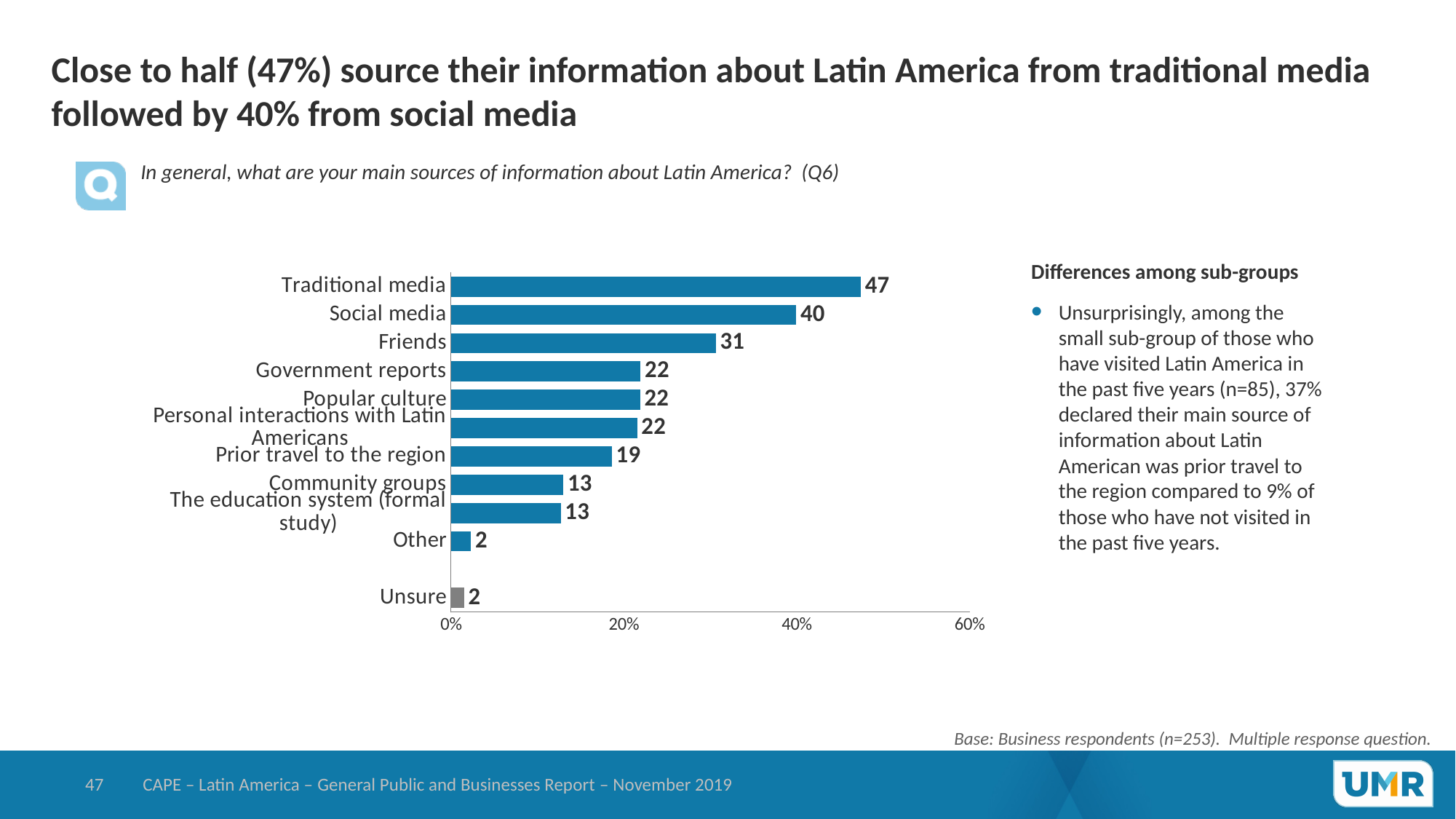
Is the value for Government reports greater or less than 20%? greater What is the value for Prior travel to the region? 19 Which category has the highest value? Traditional media What is the value for Friends? 31 What is the difference between the values for Friends and Government reports? 9 What kind of chart is shown on the slide? bar chart What is the highest value shown on the x axis? 60% What is the value for Community groups? 13 How many categories are shown in the chart? 11 What is the value for Traditional media? 47 Which is larger, the value for Social media or the value for Friends? Social media What is the difference between the values for Traditional media and Social media? 7